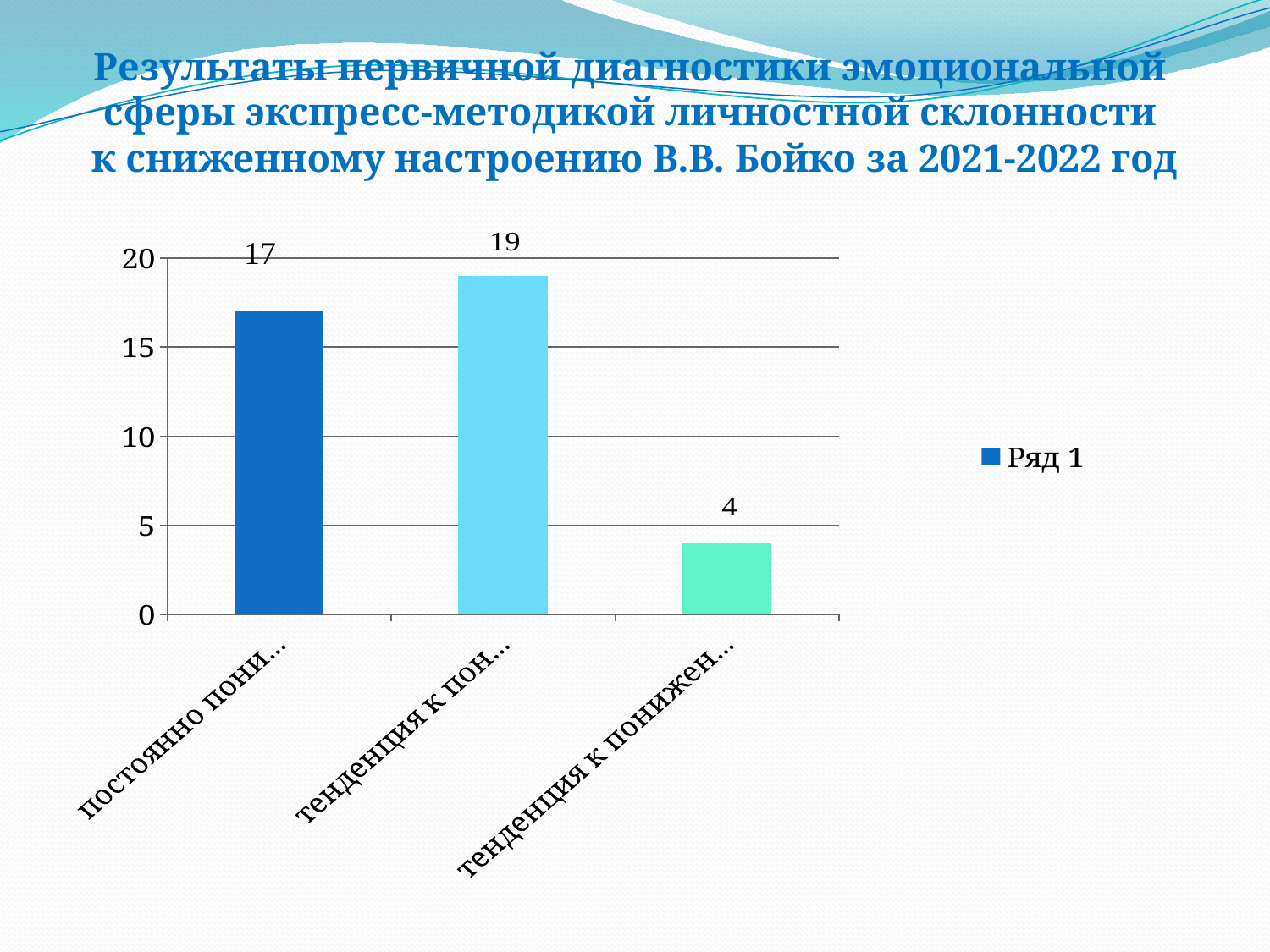
Which is larger, the first bar or the second bar? the second bar What is the value of the second (middle) bar, labelled "тенденция к пон..."? 19 What is the value of the first (leftmost) bar, labelled "постоянно пони..."? 17 What is the name of the series shown in the legend? Ряд 1 How many series does the legend list? 1 What is the difference between the second bar (19) and the third bar (4)? 15 How many bars does the chart show? 3 What is the value of the third (rightmost) bar, labelled "тенденция к понижен..."? 4 Which bar has the highest value? the second (middle) bar, "тенденция к пон..." What kind of chart is shown on the slide? bar chart Is the value of the first bar greater or less than 15? greater Which bar has the lowest value? the third (rightmost) bar, "тенденция к понижен..."